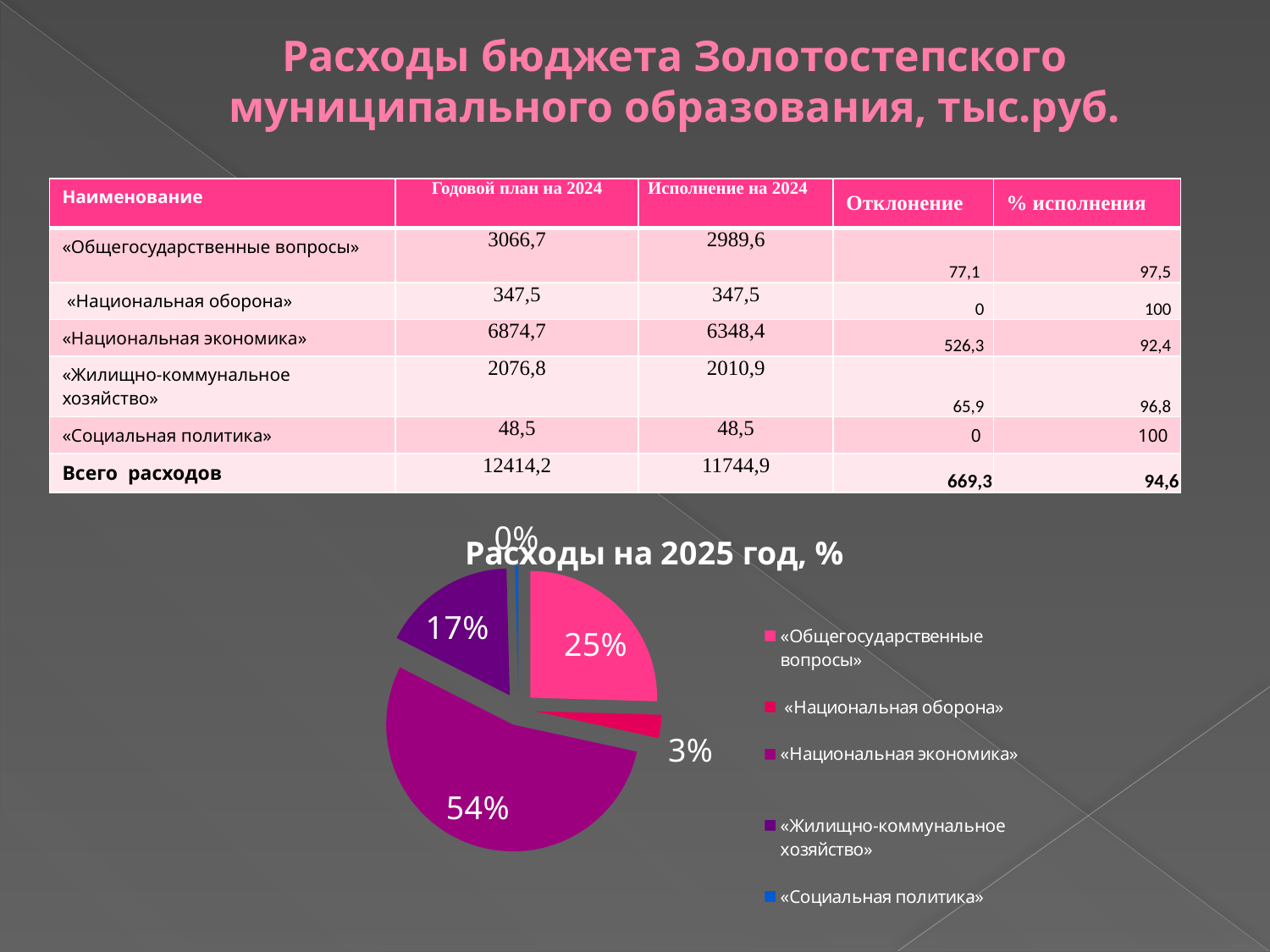
What share of the pie chart is «Социальная политика»? 0% How many entries does the pie chart legend list? 5 In the pie chart, which is larger: «Общегосударственные вопросы» or «Жилищно-коммунальное хозяйство»? «Общегосударственные вопросы» Which category has the smallest slice in the pie chart? «Социальная политика» What share of the pie chart is «Национальная оборона»? 3% What kind of chart is shown on the slide? pie chart What is the title of the pie chart? Расходы на 2025 год, % What share of the pie chart is «Общегосударственные вопросы»? 25% What is the difference in percentage points between the «Национальная экономика» slice and the «Общегосударственные вопросы» slice? 29 Which category has the largest slice in the pie chart? «Национальная экономика»